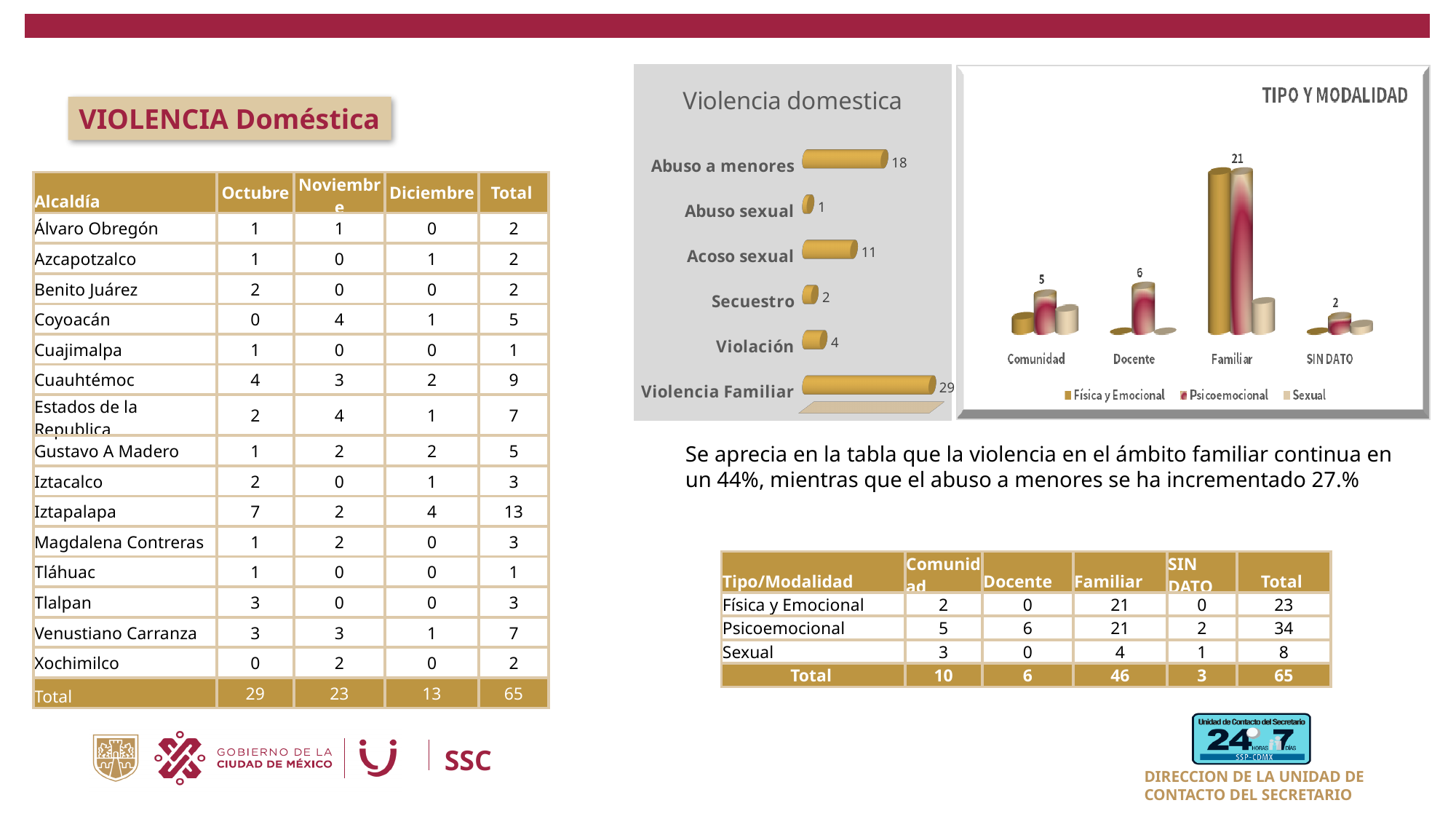
In the 'TIPO Y MODALIDAD' chart, what is the labelled value for Psicoemocional in the Familiar category? 21 How many categories are shown in the 'Violencia domestica' chart? 6 How many series does the legend of the 'TIPO Y MODALIDAD' chart list? 3 In the 'Violencia domestica' chart, what is the value for Violencia Familiar? 29 In the 'Violencia domestica' chart, which category has the highest value? Violencia Familiar In the 'Violencia domestica' chart, what is the value for Abuso a menores? 18 In the 'Violencia domestica' chart, which category has the lowest value? Abuso sexual In the 'TIPO Y MODALIDAD' chart, which category has the highest Psicoemocional value? Familiar In the 'Violencia domestica' chart, what is the value for Acoso sexual? 11 What kind of chart is the 'Violencia domestica' chart? Bar chart In the 'Violencia domestica' chart, which is larger, Violación or Secuestro? Violación In the 'Violencia domestica' chart, what is the difference between Violencia Familiar and Abuso a menores? 11